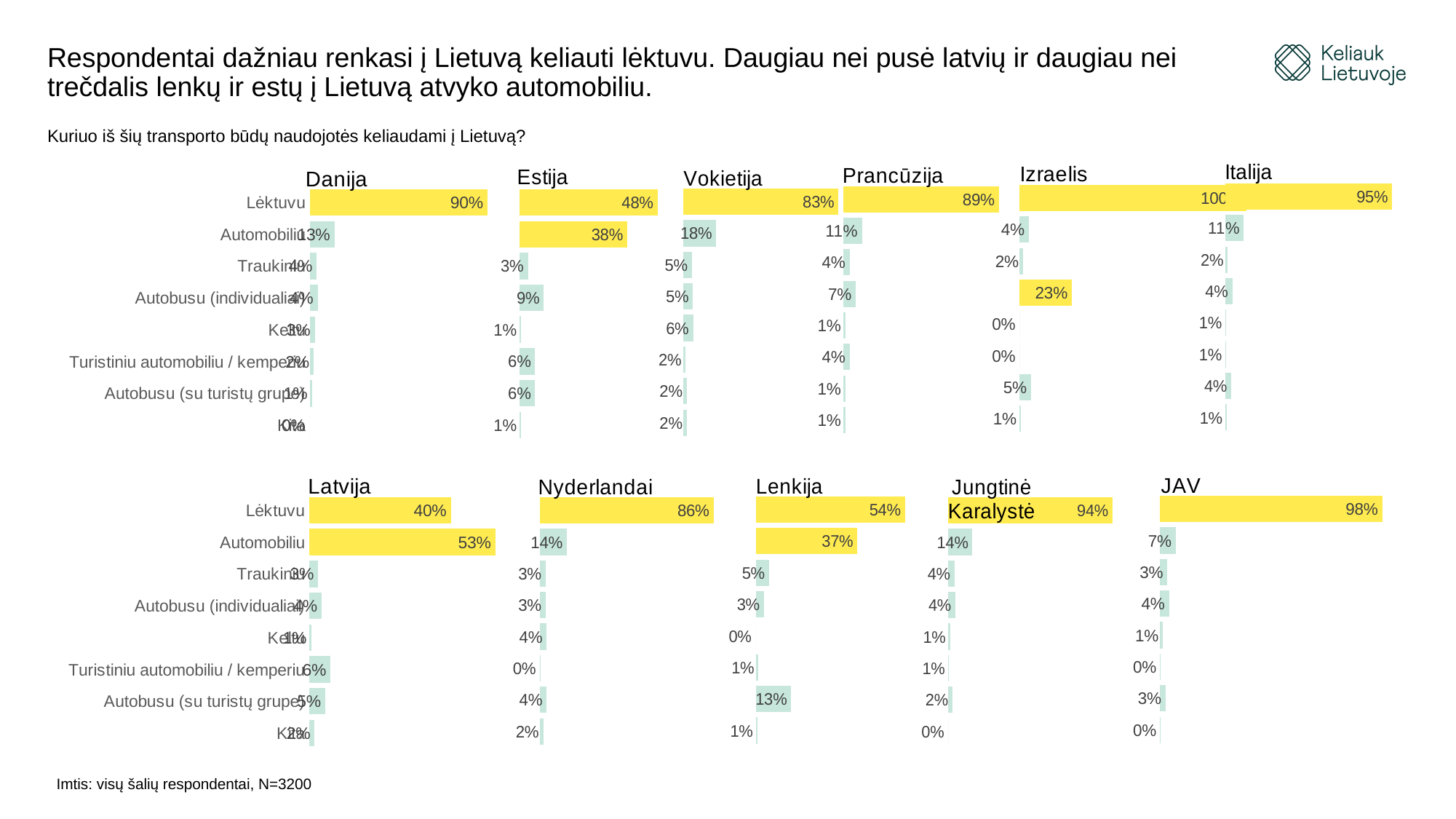
How many country charts are shown on the slide? 11 In the Lenkija chart, what is the difference between Lėktuvu and Automobiliu? 17% In the Lenkija chart, what percentage of respondents chose Autobusu (su turistų grupe)? 13% In the Estija chart, what is the difference between Lėktuvu and Automobiliu? 10% Which is larger: Lėktuvu in the Vokietija chart or Lėktuvu in the Prancūzija chart? Prancūzija In the Latvija chart, which transport mode has the highest value? Automobiliu In the Izraelis chart, what percentage of respondents chose Autobusu (individualiai)? 23% How many transport mode categories are listed in each country chart? 8 In the JAV chart, which transport mode has the highest value? Lėktuvu What type of chart is used for each country on the slide? Bar chart In the Latvija chart, what percentage of respondents chose Automobiliu? 53% In the Estija chart, what percentage of respondents chose Lėktuvu? 48%